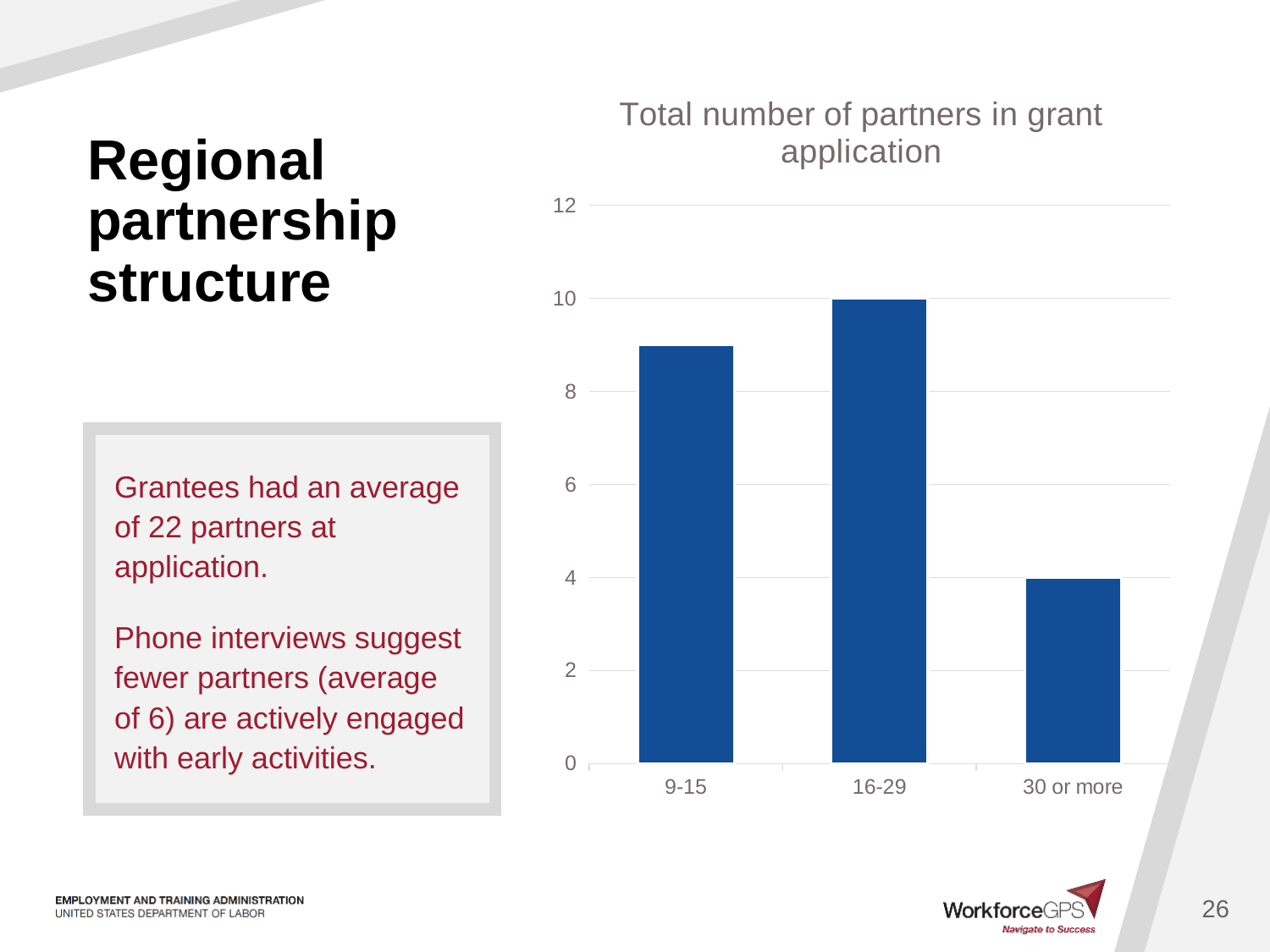
Is the value for 9-15 greater or less than 8? greater What is the difference between the value for 16-29 and the value for 30 or more? 6 Which is larger, the value for 9-15 or the value for 30 or more? 9-15 What is the title of the chart? Total number of partners in grant application What is the value for the 30 or more category? 4 Is the value for 9-15 greater or less than 10? less What is the highest value shown on the y axis of the chart? 12 How many categories are shown on the x axis of the chart? 3 What type of chart is shown on the slide? bar chart Which category has the lowest value? 30 or more What is the value for the 16-29 category? 10 Which category has the highest value? 16-29